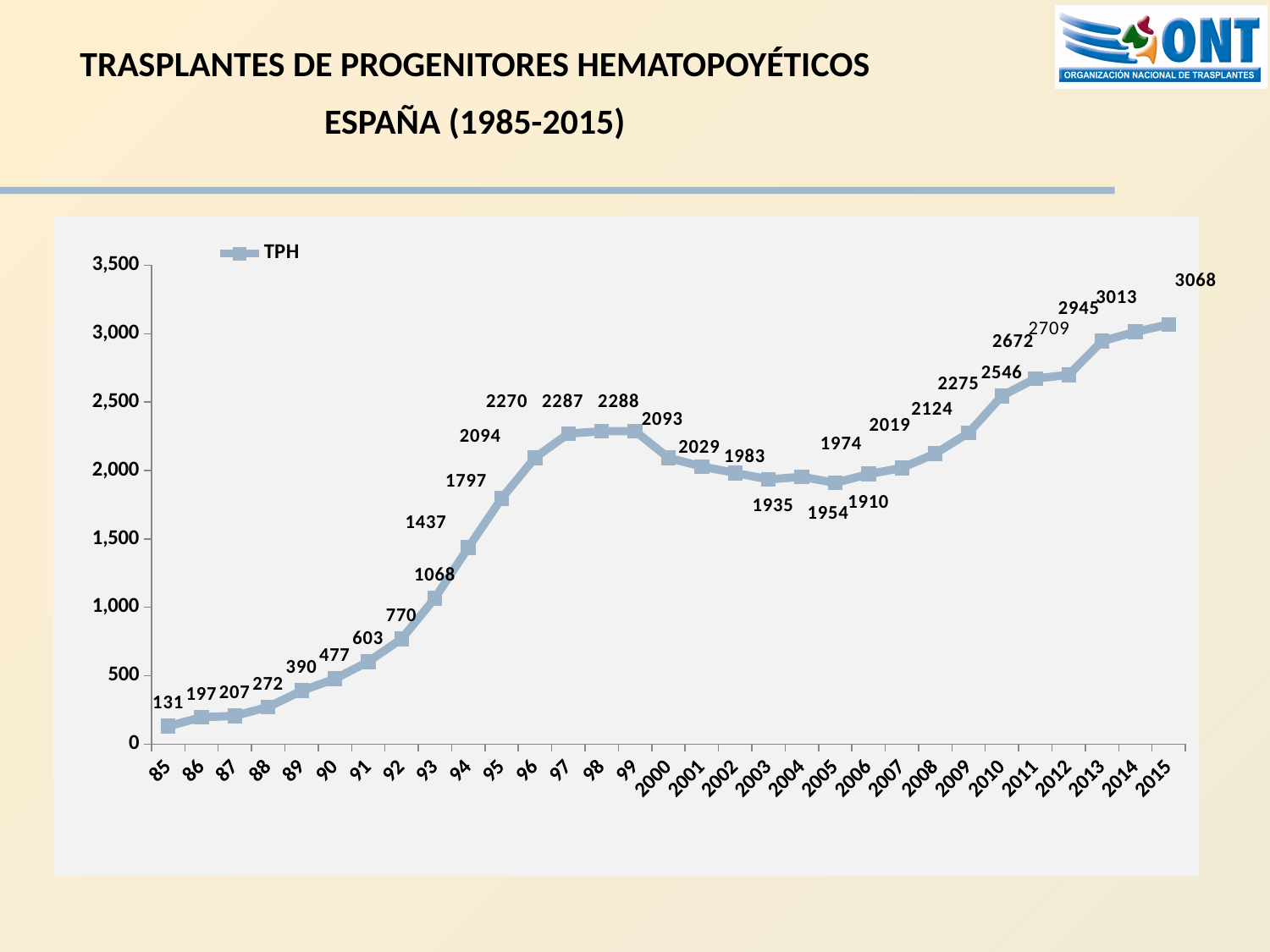
Which is larger, the TPH value for 99 or for 2000? 99 What is the TPH value for 2015? 3068 What is the TPH value for 2005? 1910 What is the TPH value for 85? 131 How many series does the legend list? 1 What is the difference between the TPH values for 2015 and 2014? 55 Which year has the highest TPH value? 2015 How many data points are plotted on the chart? 31 Which year has the lowest TPH value? 85 What is the TPH value for 98? 2287 What type of chart is shown on the slide? line chart What is the name of the series shown in the legend? TPH